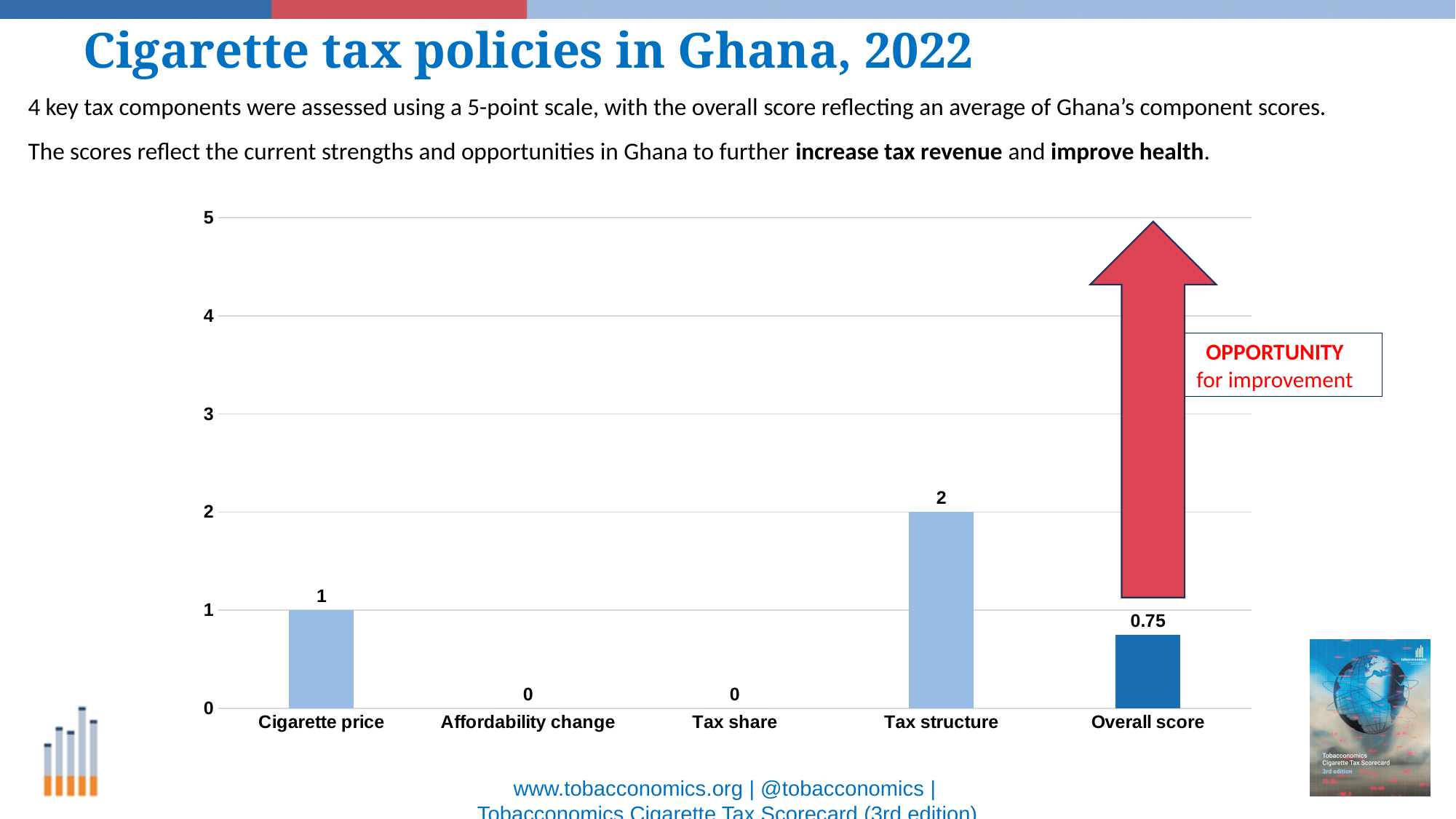
What kind of chart is shown on the slide? bar chart What is the maximum value shown on the y axis? 5 How many categories are shown on the x axis? 5 What is the value for Cigarette price? 1 Is the value for Tax structure greater or less than 1? greater What is the value for Affordability change? 0 What is the value for Tax structure? 2 Which category has the highest value? Tax structure What is the difference between the values for Tax structure and Cigarette price? 1 What is the value for Overall score? 0.75 How many categories have a value of 0? 2 Which is larger, the value for Cigarette price or the value for Overall score? Cigarette price